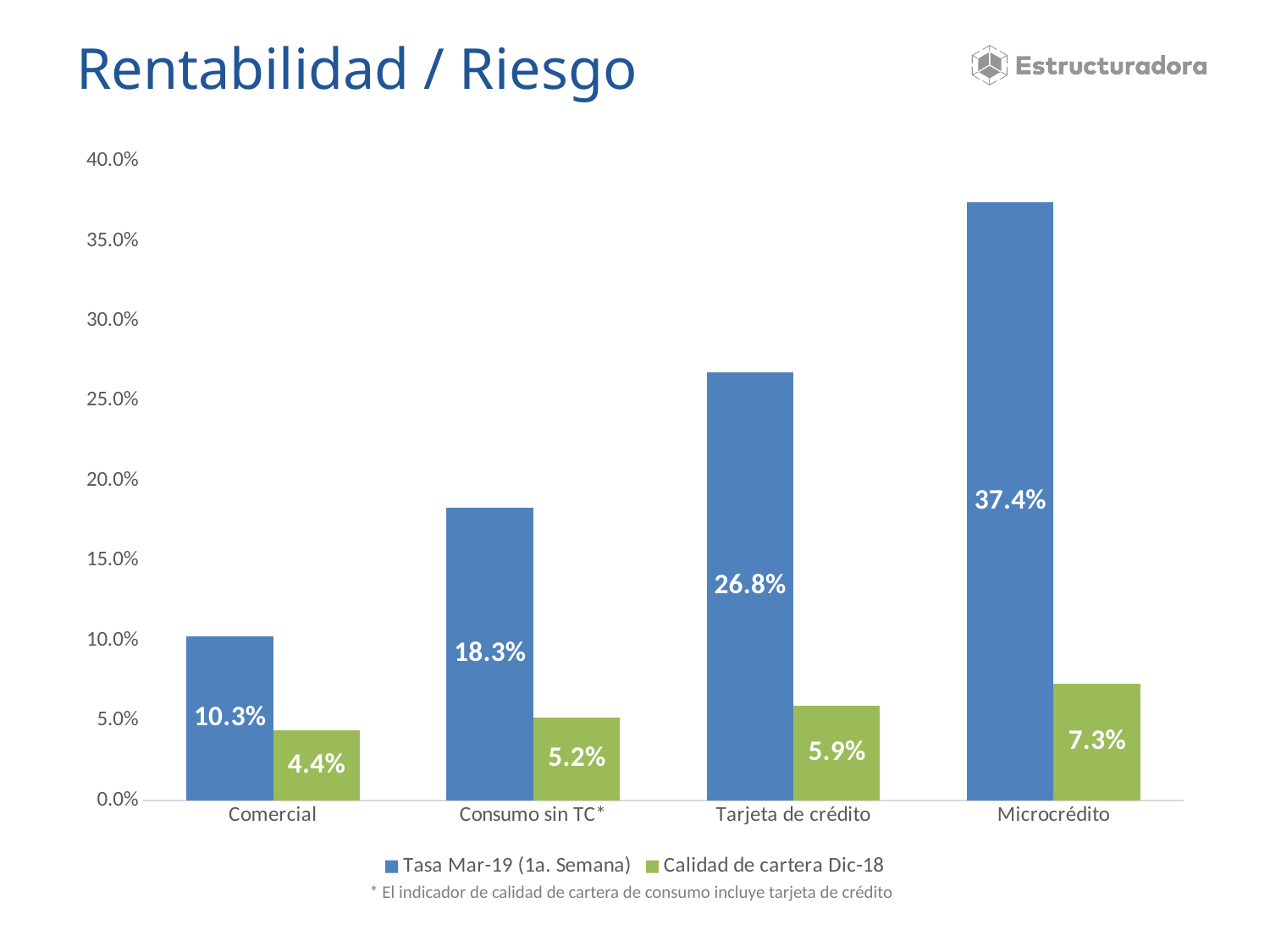
Which category has the lowest Calidad de cartera Dic-18 value? Comercial Which category has the highest Tasa Mar-19 (1a. Semana) value? Microcrédito What is the difference between the Tasa Mar-19 (1a. Semana) values for Tarjeta de crédito and Comercial? 16.5% What is the Calidad de cartera Dic-18 value for Comercial? 4.4% How many series does the legend list? 2 Is the Tasa Mar-19 (1a. Semana) value for Tarjeta de crédito greater or less than 25.0%? greater Do the Tasa Mar-19 (1a. Semana) values rise or fall from Comercial to Microcrédito? Rise What kind of chart is shown on the slide? Bar chart How many categories are shown on the x axis? 4 What is the Tasa Mar-19 (1a. Semana) value for Consumo sin TC*? 18.3% Which is larger: the Calidad de cartera Dic-18 value for Tarjeta de crédito or for Consumo sin TC*? Tarjeta de crédito What is the Tasa Mar-19 (1a. Semana) value for Microcrédito? 37.4%